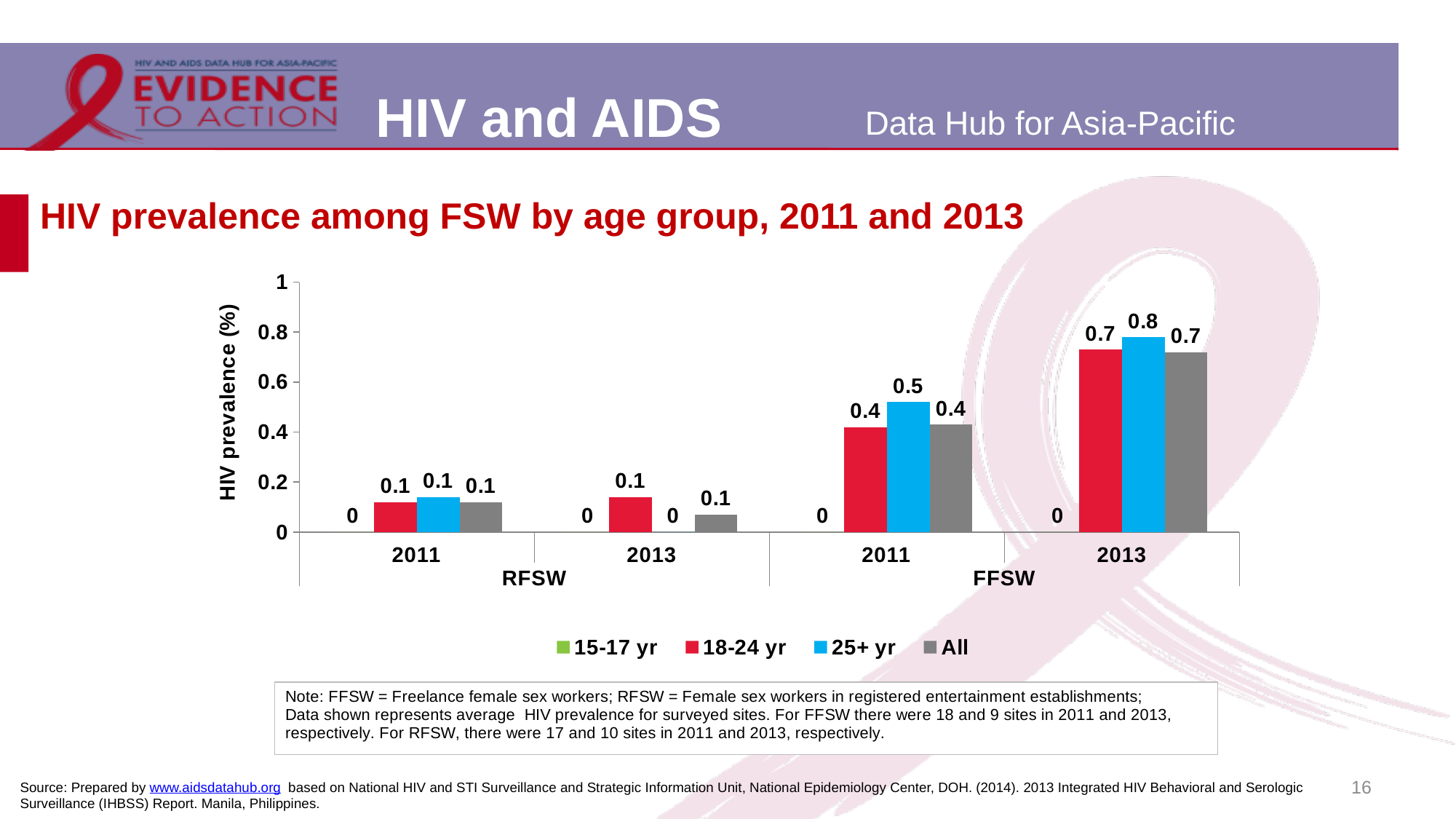
Is the All value for FFSW in 2013 larger or smaller than the All value for FFSW in 2011? larger What is the HIV prevalence for the 15-17 yr group among FFSW in 2013? 0 What kind of chart is shown on the slide? bar chart What is the difference between the 25+ yr value for FFSW in 2013 and the 25+ yr value for FFSW in 2011? 0.3 What is the HIV prevalence for the 18-24 yr group among FFSW in 2011? 0.4 What is the HIV prevalence for the All group among RFSW in 2013? 0.1 Which age group has the highest HIV prevalence among FFSW in 2013? 25+ yr Is the value for the 25+ yr group among FFSW in 2011 greater or less than 0.4? greater What is the HIV prevalence for the 25+ yr group among FFSW in 2013? 0.8 How many series does the legend list? 4 What is the label of the y axis? HIV prevalence (%) How many year-group categories are shown along the x axis? 4